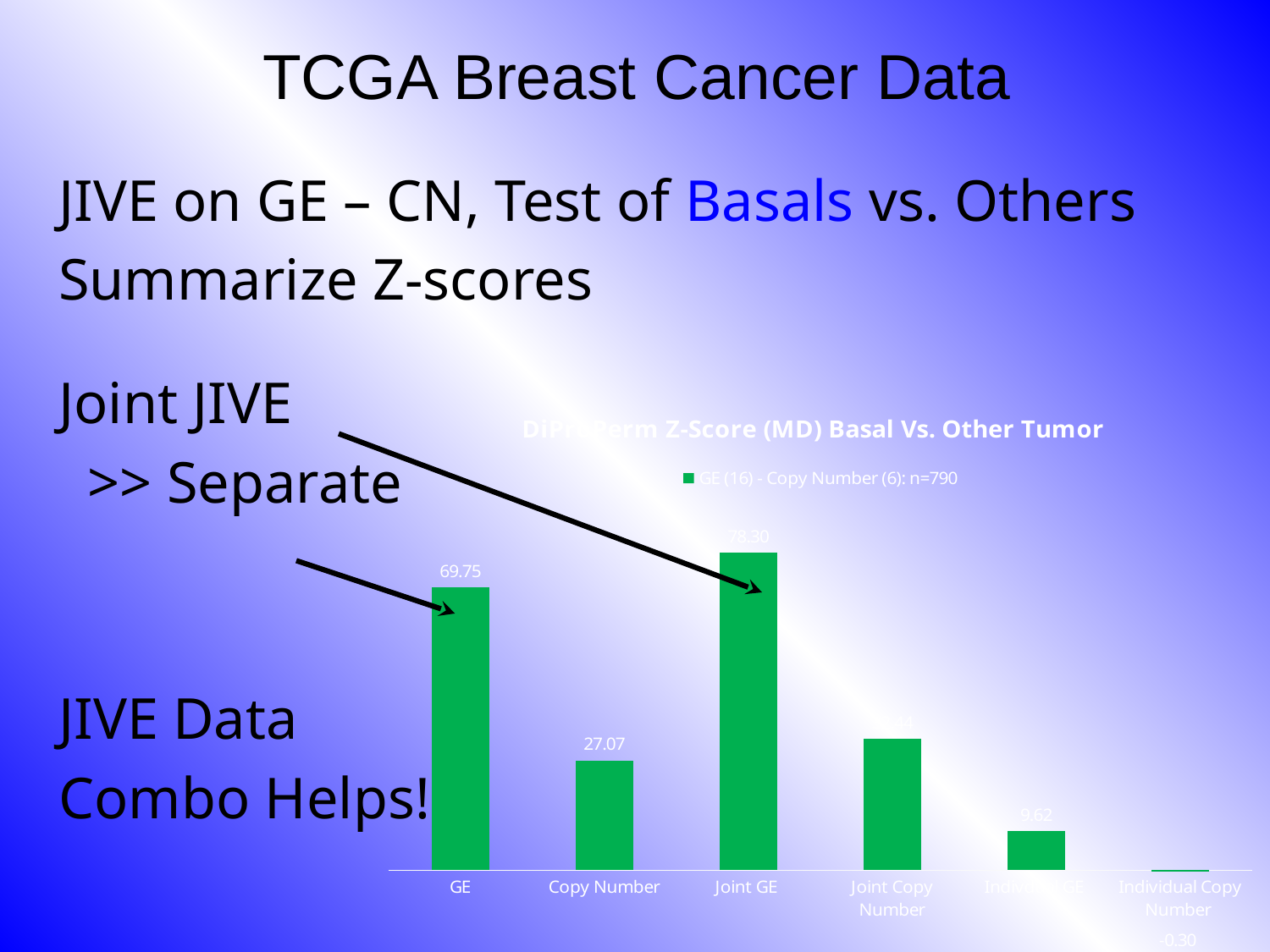
Which category has the lowest value in the chart? Individual Copy Number Which is larger, the value for GE or the value for Copy Number? GE What is the difference between the values for Joint GE and GE? 8.55 What is the value for Joint GE in the chart? 78.30 What is the value for Individual Copy Number in the chart? -0.30 How many series does the chart's legend list? 1 What is the value for GE in the chart? 69.75 Which category has the highest value in the chart? Joint GE What kind of chart is shown on the slide? bar chart What is the value for Individual GE in the chart? 9.62 What is the value for Copy Number in the chart? 27.07 How many categories are plotted on the x axis of the chart? 6